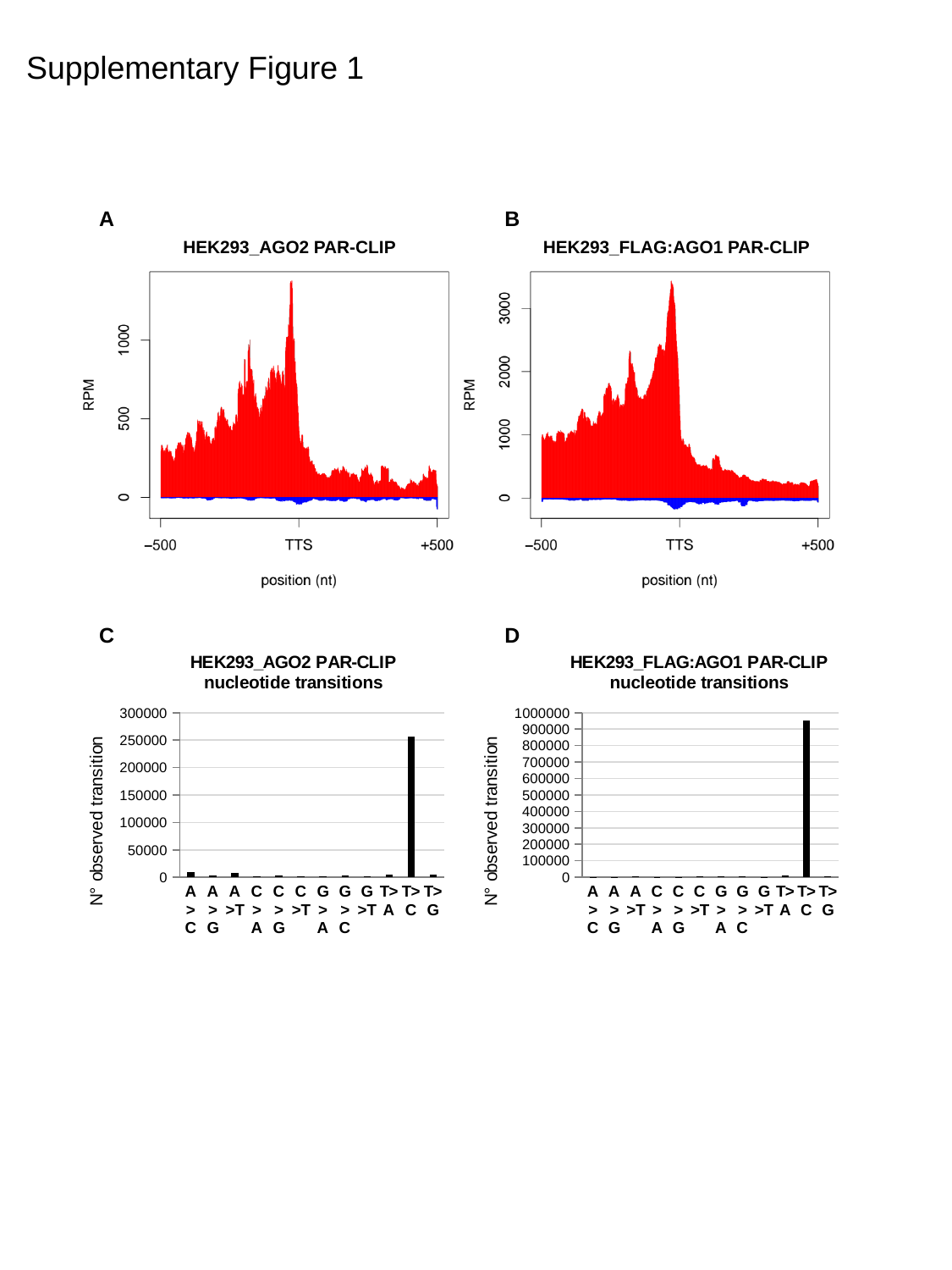
In chart C, which is larger, the value for A>C or the value for T>C? T>C In chart D, is the value for T>C greater or less than 900000? greater In chart B (HEK293_FLAG:AGO1 PAR-CLIP), do the red RPM values rise or fall from the TTS toward +500? fall In chart A (HEK293_AGO2 PAR-CLIP), is the peak RPM value near the TTS greater or less than 1000? greater In chart C (HEK293_AGO2 PAR-CLIP nucleotide transitions), which nucleotide transition has the highest number of observed transitions? T>C What kind of chart is chart C (HEK293_AGO2 PAR-CLIP nucleotide transitions)? bar chart In chart D (HEK293_FLAG:AGO1 PAR-CLIP nucleotide transitions), which nucleotide transition has the highest number of observed transitions? T>C What is the x-axis label of chart A (HEK293_AGO2 PAR-CLIP)? position (nt) In chart C, is the value for T>C greater or less than 200000? greater How many nucleotide transition categories are shown on the x axis of chart C? 12 What is the y-axis label of chart D? N° observed transition